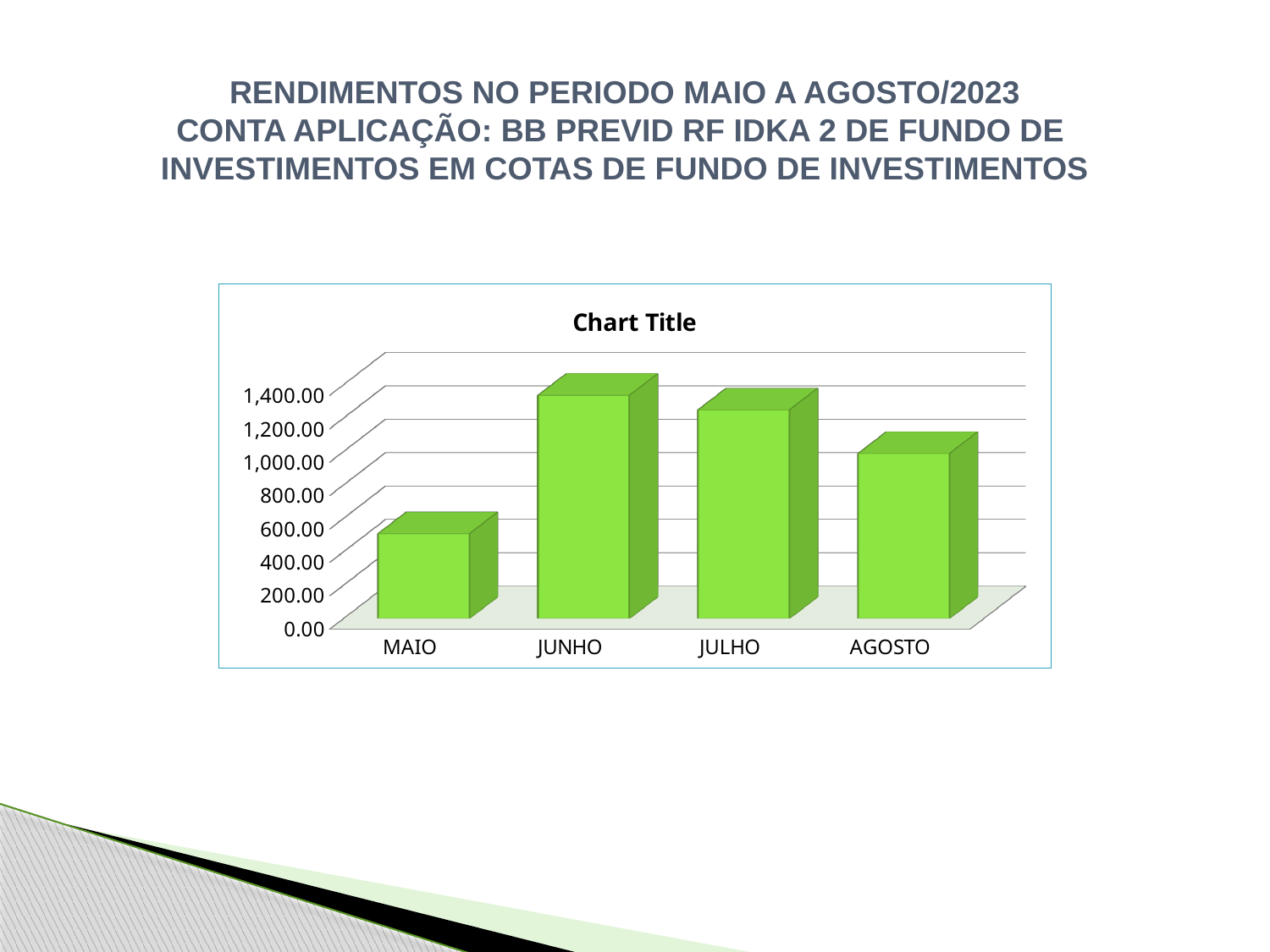
Which month has the lowest bar in the chart? MAIO What title is printed above the chart's plot area? Chart Title How many categories are shown on the x axis of the chart? 4 Which is larger, the value for JULHO or the value for AGOSTO? JULHO Is the value for JULHO greater or less than 1,000.00? greater Is the value for AGOSTO greater or less than 800.00? greater What kind of chart is shown on the slide? bar chart Is the value for JUNHO greater or less than 1,000.00? greater Do the values rise or fall from JUNHO to AGOSTO? fall Which is larger, the value for JUNHO or the value for MAIO? JUNHO Which month has the highest bar in the chart? JUNHO